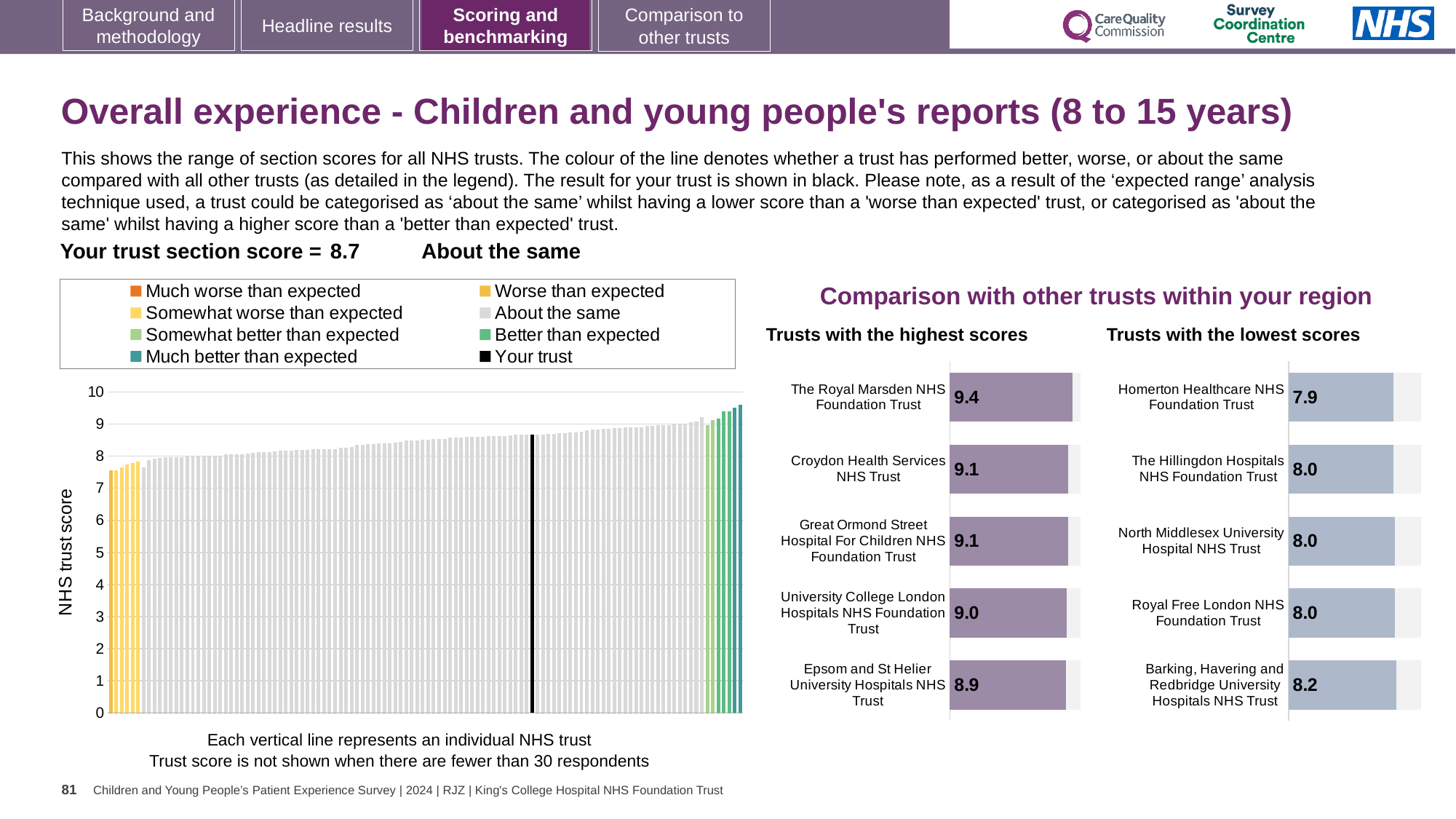
How many trusts are shown in the 'Trusts with the lowest scores' chart? 5 What kind of chart is the large chart on the left showing all NHS trusts? Bar chart In the 'Trusts with the highest scores' chart, what is the difference between the scores of The Royal Marsden NHS Foundation Trust and Epsom and St Helier University Hospitals NHS Trust? 0.5 In the 'Trusts with the lowest scores' chart, what is the difference between the scores of Barking, Havering and Redbridge University Hospitals NHS Trust and Homerton Healthcare NHS Foundation Trust? 0.3 What is the y-axis label of the large chart on the left? NHS trust score In the 'Trusts with the highest scores' chart, which has the larger score: The Royal Marsden NHS Foundation Trust or University College London Hospitals NHS Foundation Trust? The Royal Marsden NHS Foundation Trust In the 'Trusts with the lowest scores' chart, which trust has the highest score? Barking, Havering and Redbridge University Hospitals NHS Trust In the 'Trusts with the highest scores' chart, which trust has the lowest score? Epsom and St Helier University Hospitals NHS Trust In the 'Trusts with the highest scores' chart, what is the score for The Royal Marsden NHS Foundation Trust? 9.4 In the large chart on the left, is the value for the black 'Your trust' bar greater or less than 8? greater In the 'Trusts with the lowest scores' chart, what is the score for Homerton Healthcare NHS Foundation Trust? 7.9 How many entries does the legend above the large chart on the left list? 8